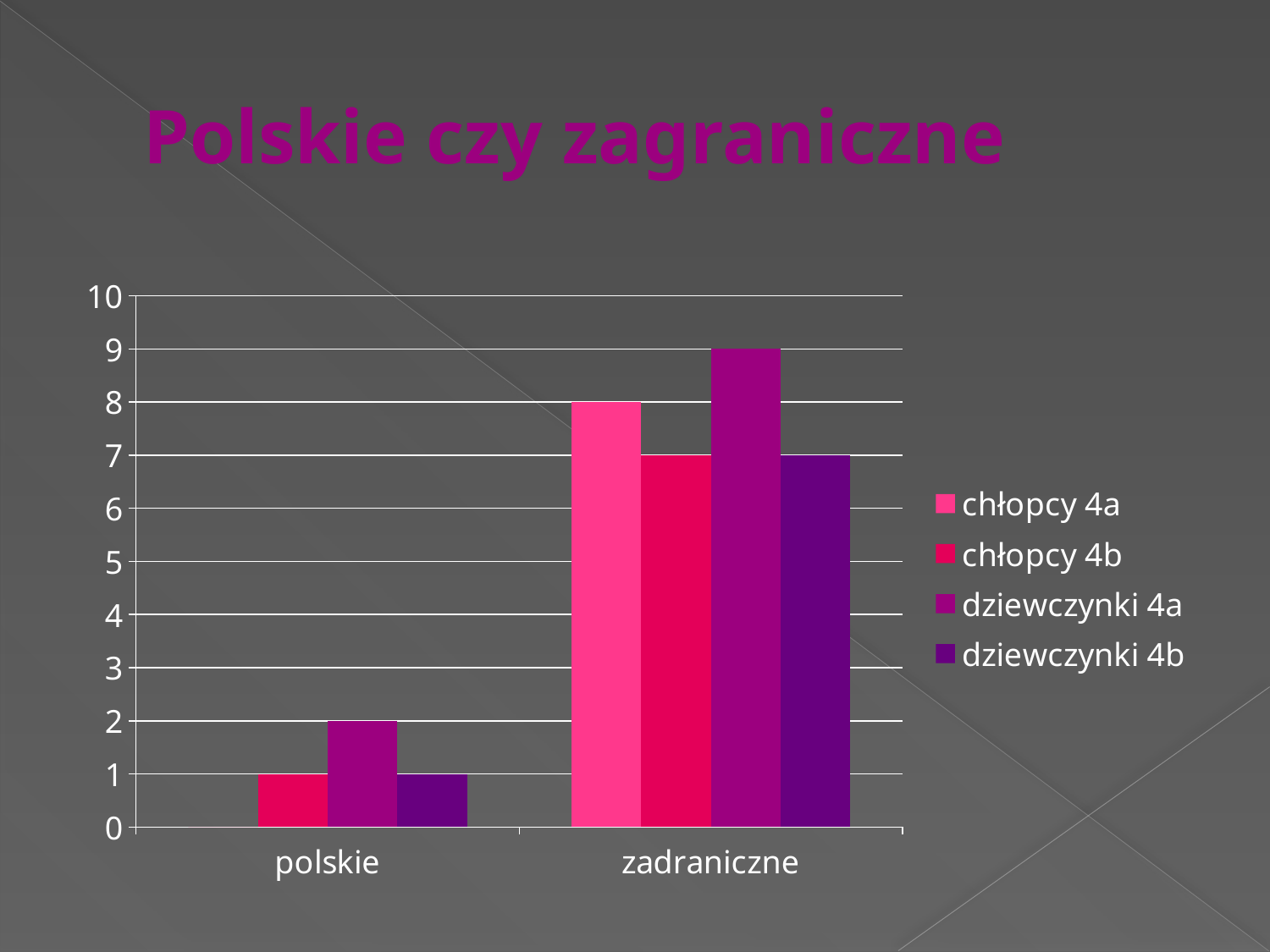
How many series does the legend list? 4 What is the value for chłopcy 4b in the polskie category? 1 What is the value for chłopcy 4a in the zadraniczne category? 8 What kind of chart is shown on the slide? bar chart Which is larger: chłopcy 4a in zadraniczne or dziewczynki 4b in zadraniczne? chłopcy 4a in zadraniczne What is the value for dziewczynki 4a in the polskie category? 2 What is the title of the slide? Polskie czy zagraniczne Which series has the highest value in the polskie category? dziewczynki 4a Which series has the highest value in the zadraniczne category? dziewczynki 4a What is the value for dziewczynki 4a in the zadraniczne category? 9 What is the difference between dziewczynki 4a and chłopcy 4b in the zadraniczne category? 2 How many categories are shown on the x axis? 2